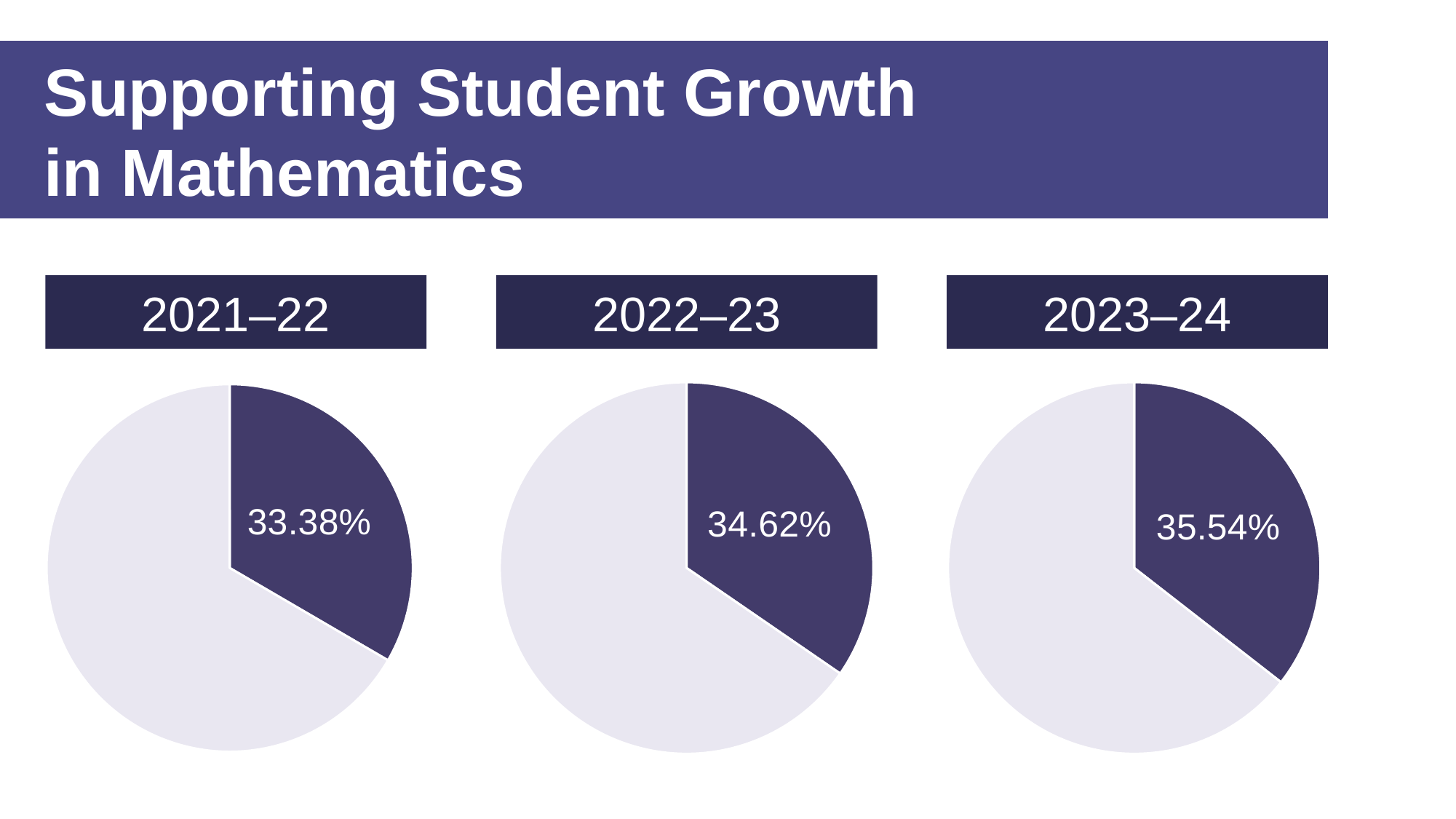
How many pie charts are on the slide? 3 What is the difference between the labelled percentage in the 2022–23 pie chart and the 2021–22 pie chart? 1.24% What is the difference between the labelled percentage in the 2023–24 pie chart and the 2021–22 pie chart? 2.16% Which year's pie chart has the smallest labelled dark slice? 2021–22 What is the title of the slide containing the pie charts? Supporting Student Growth in Mathematics In the 2021–22 pie chart, what percentage is shown on the dark slice? 33.38% Is the labelled dark slice larger in the 2022–23 pie chart or the 2023–24 pie chart? 2023–24 In the 2023–24 pie chart, what percentage is shown on the dark slice? 35.54% Do the labelled percentages rise or fall from the 2021–22 pie chart to the 2023–24 pie chart? Rise What kind of charts are shown on the slide? Pie charts In the 2022–23 pie chart, what percentage is shown on the dark slice? 34.62% Which year's pie chart has the largest labelled dark slice? 2023–24